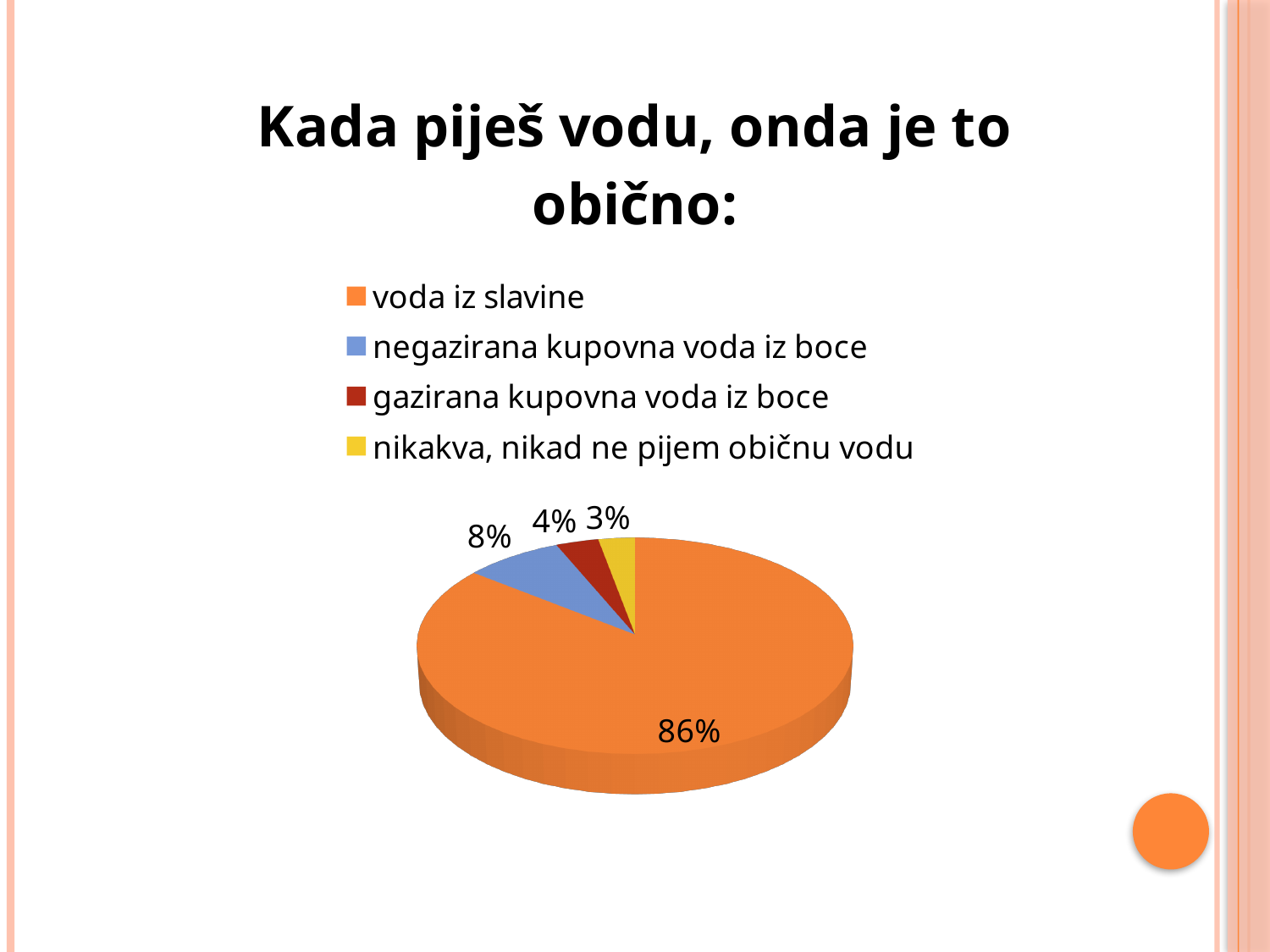
Which is larger: the share for 'negazirana kupovna voda iz boce' or 'gazirana kupovna voda iz boce'? negazirana kupovna voda iz boce What kind of chart is shown on the slide? pie chart Which category has the smallest share of the pie? nikakva, nikad ne pijem običnu vodu What percentage of the pie is 'voda iz slavine'? 86% Which category has the largest share of the pie? voda iz slavine What colour is the slice for 'negazirana kupovna voda iz boce'? blue What percentage of the pie is 'negazirana kupovna voda iz boce'? 8% What percentage of the pie is 'gazirana kupovna voda iz boce'? 4% What is the difference in percentage points between 'voda iz slavine' and 'negazirana kupovna voda iz boce'? 78 How many slices does the pie chart have? 4 What is the title of the chart? Kada piješ vodu, onda je to obično: What percentage of the pie is 'nikakva, nikad ne pijem običnu vodu'? 3%